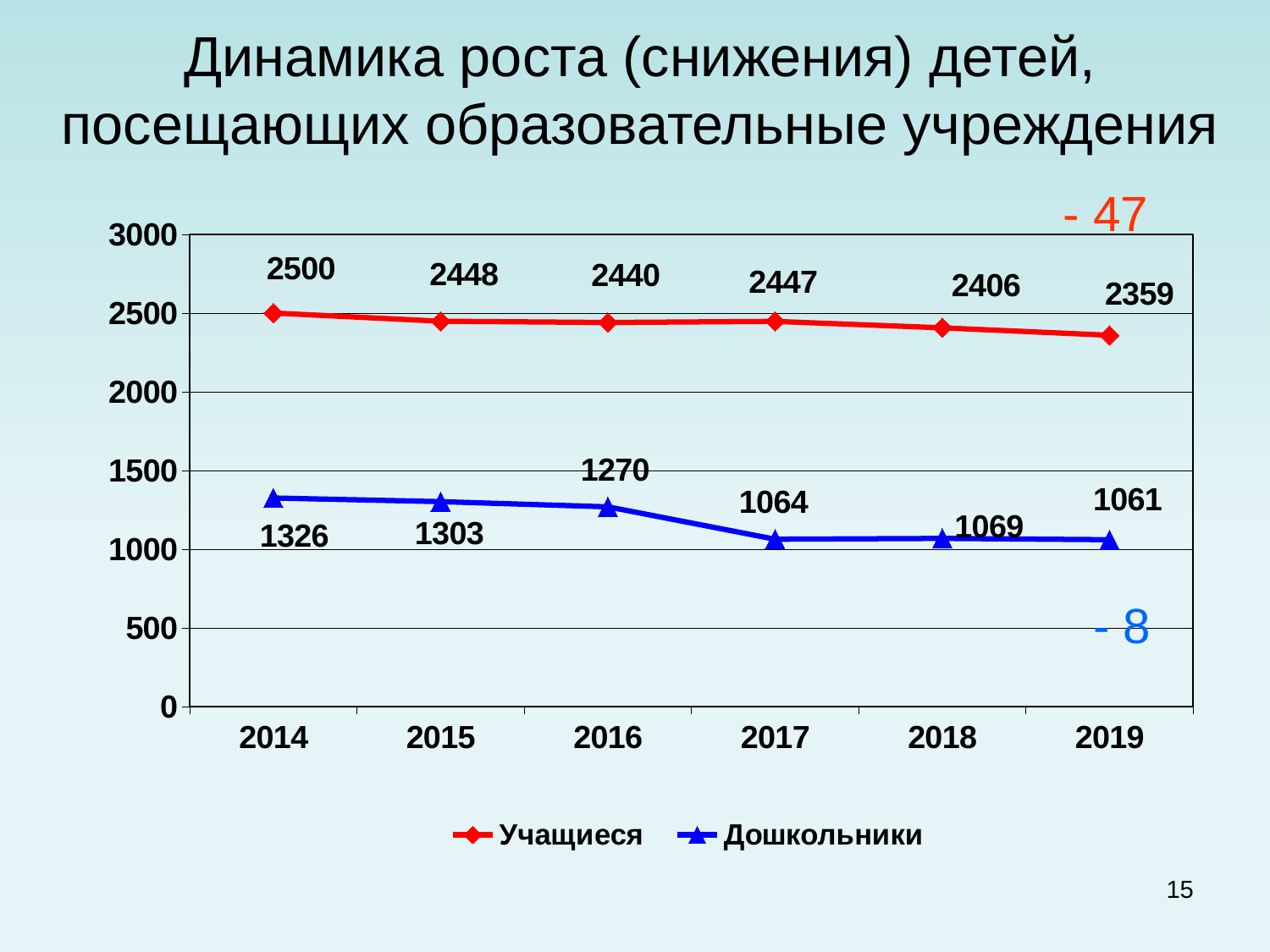
How many years are shown on the x axis? 6 What is the value for Учащиеся in 2019? 2359 Which is larger in 2016: the value for Учащиеся or the value for Дошкольники? Учащиеся How many series does the legend list? 2 What is the value for Учащиеся in 2014? 2500 In which year is the value for Учащиеся lowest? 2019 What is the value for Дошкольники in 2017? 1064 Do the values for Учащиеся generally rise or fall from 2014 to 2019? fall What kind of chart is shown on the slide? line chart What is the difference between the Дошкольники values in 2016 and 2017? 206 What is the difference between the Учащиеся values in 2018 and 2019? 47 In which year is the value for Дошкольники highest? 2014